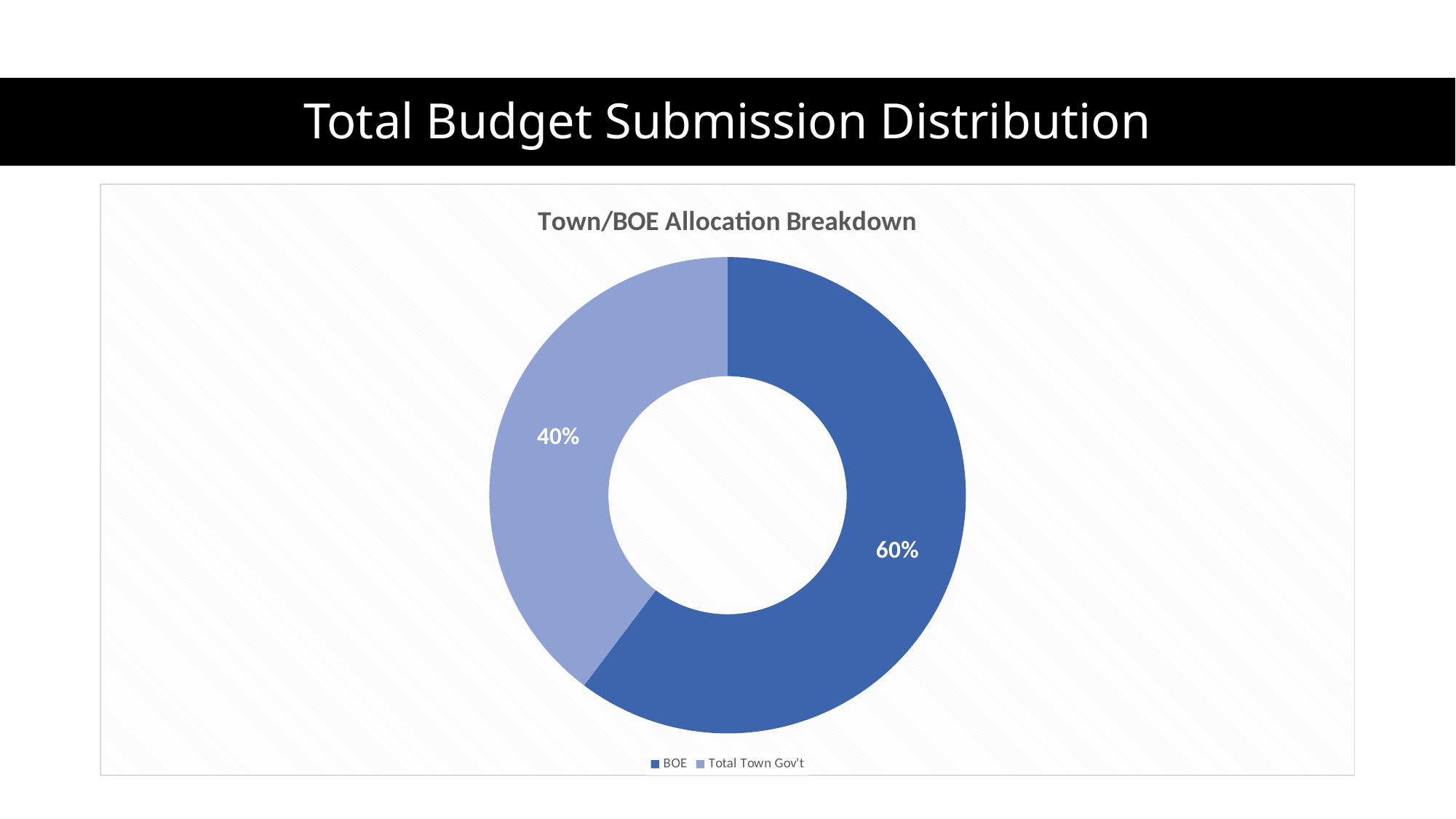
Which category has the largest slice in the Town/BOE Allocation Breakdown chart? BOE What is the title of the chart on the slide? Town/BOE Allocation Breakdown Which category has the smallest slice in the Town/BOE Allocation Breakdown chart? Total Town Gov't What share of the Town/BOE Allocation Breakdown chart does Total Town Gov't represent? 40% What kind of chart is shown on the slide? Doughnut (pie) chart How many categories are shown in the Town/BOE Allocation Breakdown chart? 2 How many entries does the legend of the Town/BOE Allocation Breakdown chart list? 2 Which legend entry is shown in the darker blue colour? BOE What share of the Town/BOE Allocation Breakdown chart does BOE represent? 60% What is the difference in percentage points between the BOE and Total Town Gov't slices? 20 percentage points Which is larger, the BOE slice or the Total Town Gov't slice? BOE